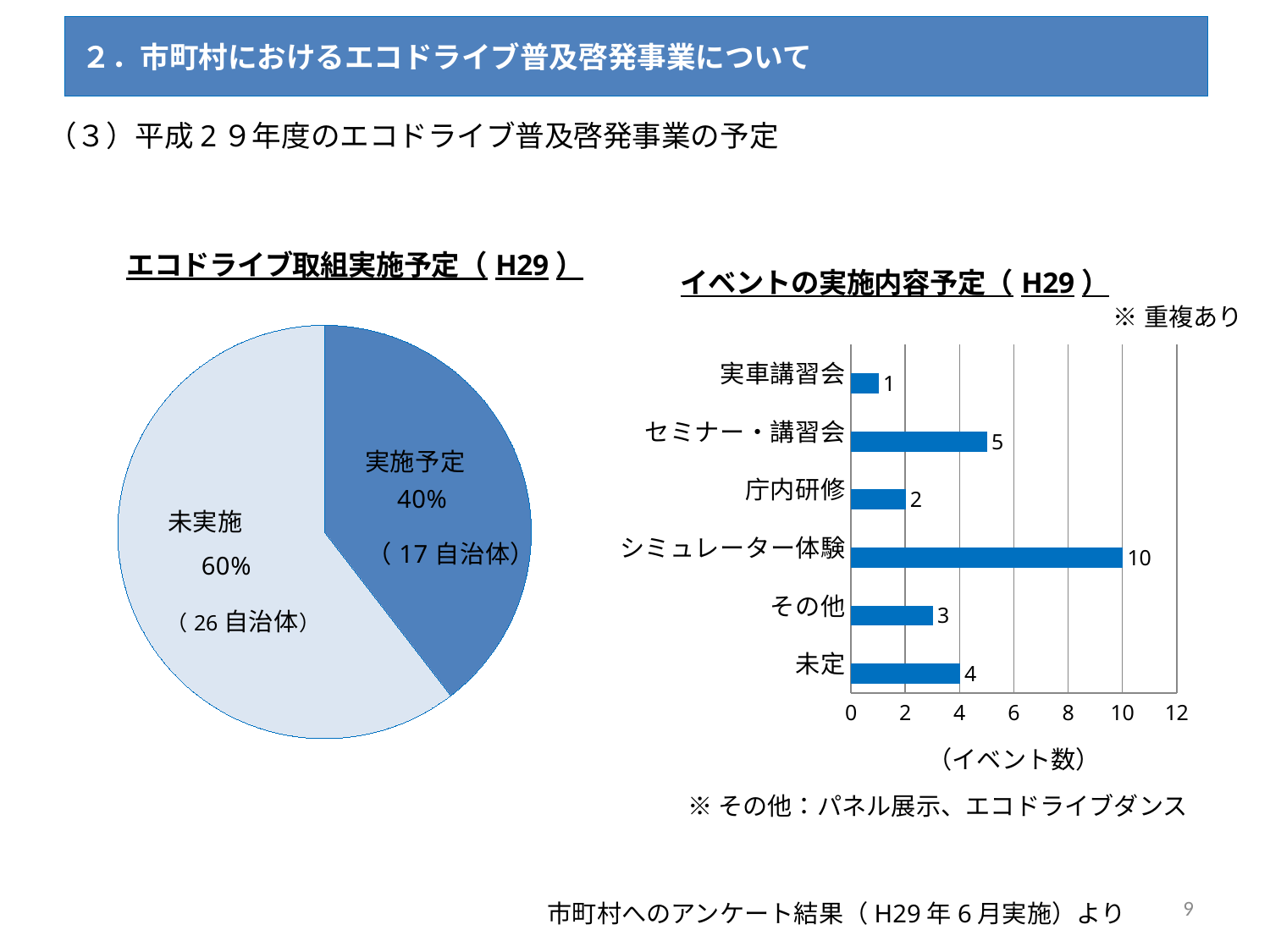
In the pie chart titled エコドライブ取組実施予定（H29）, how many 自治体 are in the 未実施 slice? 26 What kind of chart is the chart titled イベントの実施内容予定（H29）? bar chart In the pie chart titled エコドライブ取組実施予定（H29）, which slice is larger, 実施予定 or 未実施? 未実施 In the pie chart titled エコドライブ取組実施予定（H29）, what share does 実施予定 have? 40% In the bar chart titled イベントの実施内容予定（H29）, what is the value for シミュレーター体験? 10 In the pie chart titled エコドライブ取組実施予定（H29）, how many slices are there? 2 In the bar chart titled イベントの実施内容予定（H29）, which category has the highest value? シミュレーター体験 In the bar chart titled イベントの実施内容予定（H29）, what is the difference between シミュレーター体験 and 未定? 6 In the bar chart titled イベントの実施内容予定（H29）, what is the value for セミナー・講習会? 5 In the bar chart titled イベントの実施内容予定（H29）, which category has the lowest value? 実車講習会 In the bar chart titled イベントの実施内容予定（H29）, which is larger, その他 or 庁内研修? その他 In the bar chart titled イベントの実施内容予定（H29）, how many categories are shown? 6